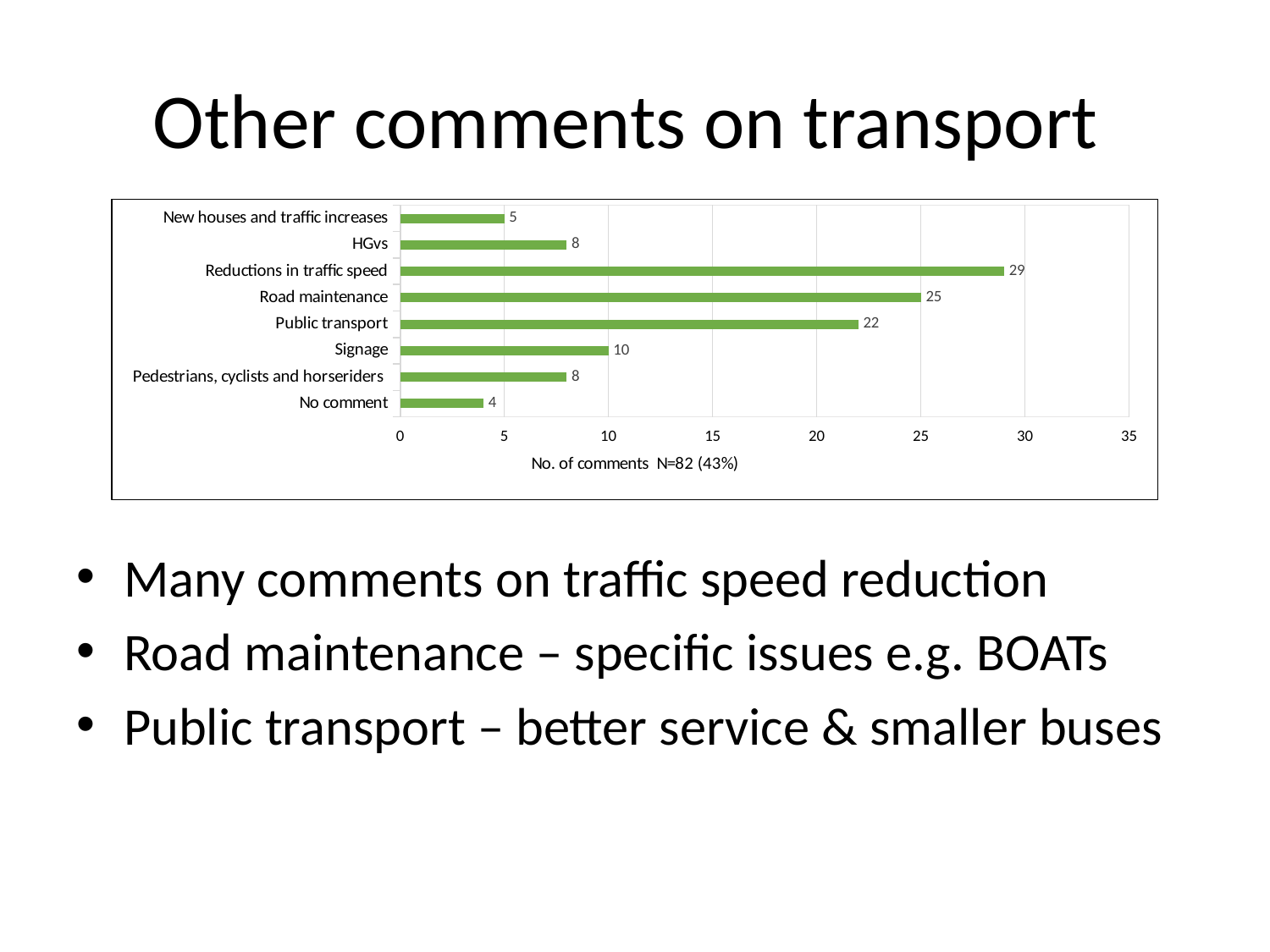
Which category received the most comments? Reductions in traffic speed Which category has the lowest number of comments? No comment What type of chart is shown on the slide? Bar chart How many categories are shown in the chart? 8 What is the difference between the number of comments on Reductions in traffic speed and on Public transport? 7 What is the value for New houses and traffic increases? 5 Which has more comments, Road maintenance or Public transport? Road maintenance What is the number of comments for Road maintenance? 25 What is the difference between the number of comments for Signage and for HGvs? 2 What is the x-axis label of the chart? No. of comments N=82 (43%) How many comments were about Signage? 10 How many comments were there about reductions in traffic speed? 29